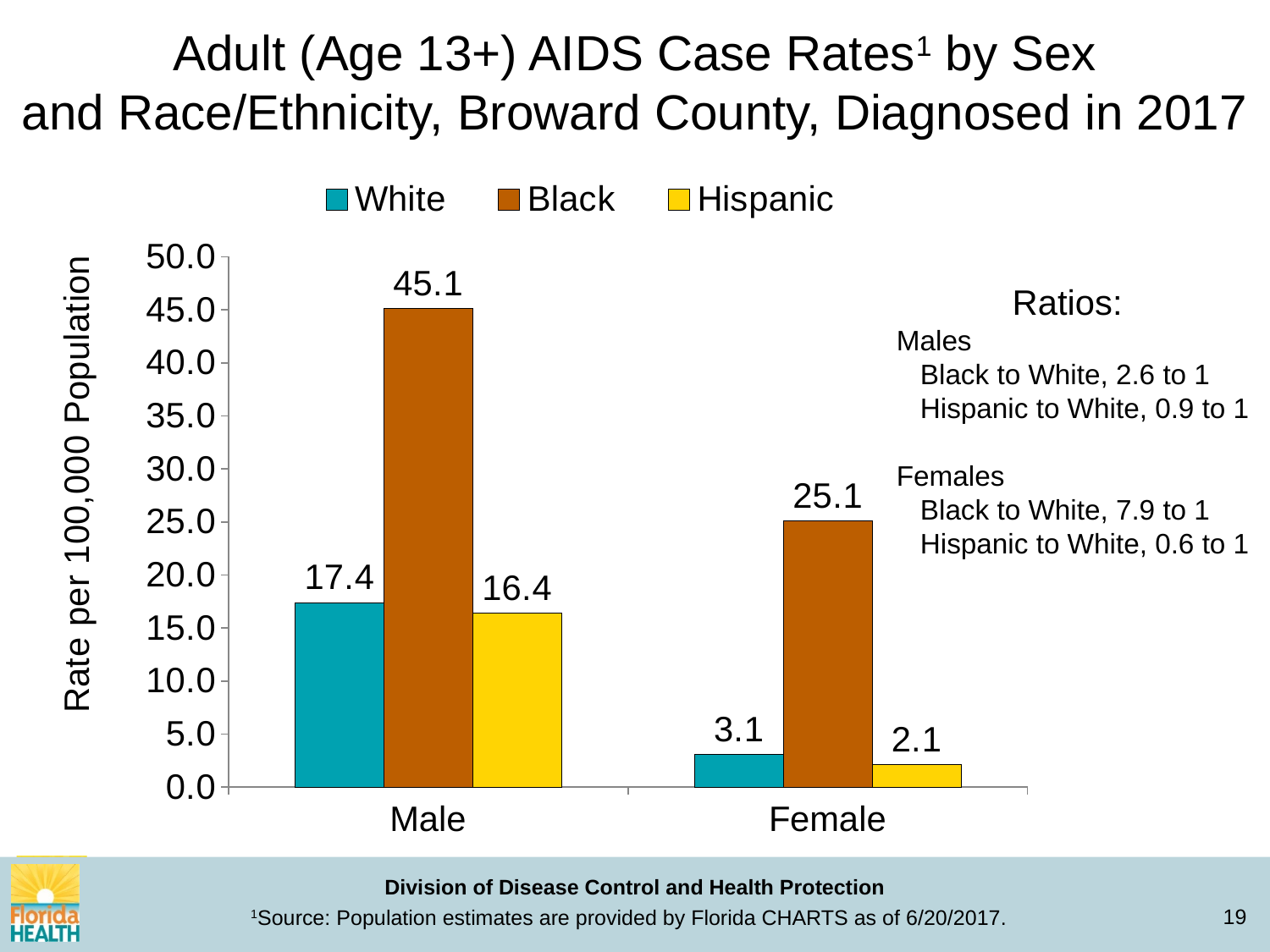
Is the value for Black females greater or less than 20.0? greater Which is larger, the White female rate or the Hispanic female rate? White female rate What is the label of the vertical axis? Rate per 100,000 Population Which race/ethnicity group has the lowest rate among males? Hispanic What is the AIDS case rate for Hispanic females? 2.1 How many series does the legend list? 3 What kind of chart is shown on the slide? Bar chart What is the AIDS case rate for Black males? 45.1 What is the AIDS case rate for White males? 17.4 Which race/ethnicity group has the highest rate among females? Black What is the difference between the Black male rate and the Black female rate? 20.0 What is the difference between the White male rate and the Hispanic male rate? 1.0